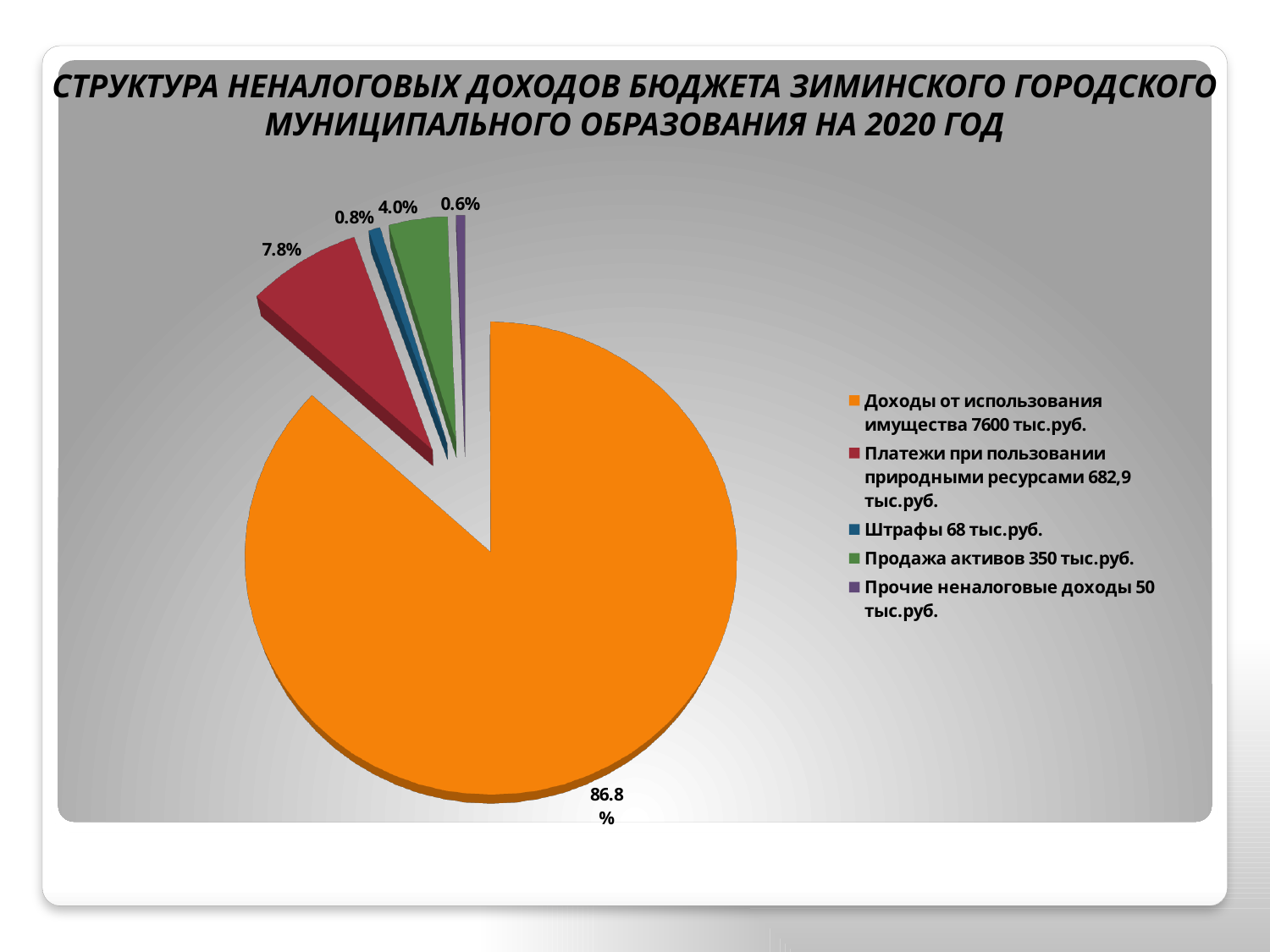
How many slices does the pie chart have? 5 What share of the pie is labelled for 'Прочие неналоговые доходы'? 0.6% What type of chart is shown on the slide? Pie chart What share of the pie is labelled for 'Продажа активов'? 4.0% What share of the pie is labelled for 'Доходы от использования имущества'? 86.8% Which category has the largest share of the pie? Доходы от использования имущества Which colour represents 'Штрафы 68 тыс.руб.' in the legend? Blue Which category has the smallest share of the pie? Прочие неналоговые доходы What is the difference in percentage points between the shares for 'Платежи при пользовании природными ресурсами' and 'Продажа активов'? 3.8 How many entries does the legend list? 5